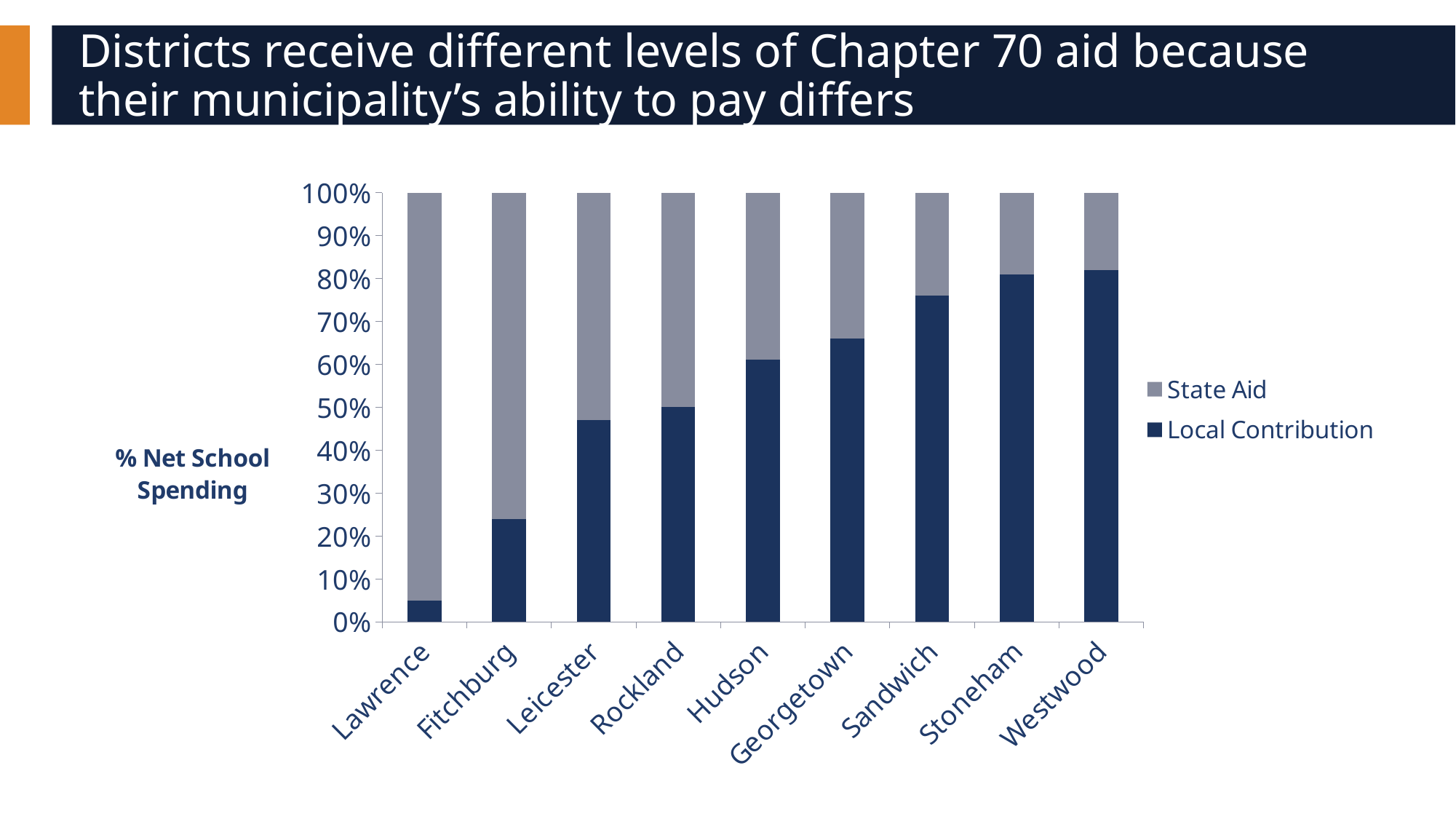
Is the Local Contribution for Fitchburg greater or less than 30%? less Which district has the largest State Aid share? Lawrence Does the Local Contribution share rise or fall moving from Lawrence to Westwood along the x axis? Rise What kind of chart is shown on the slide? Stacked bar chart Which has a larger Local Contribution share, Leicester or Georgetown? Georgetown How many districts are shown on the x axis of the chart? 9 How many series does the chart legend list? 2 Which district has the smallest Local Contribution share? Lawrence What is the label on the vertical axis of the chart? % Net School Spending What is the total height of the stacked bar for Rockland? 100% Is the Local Contribution for Sandwich greater or less than 70%? greater